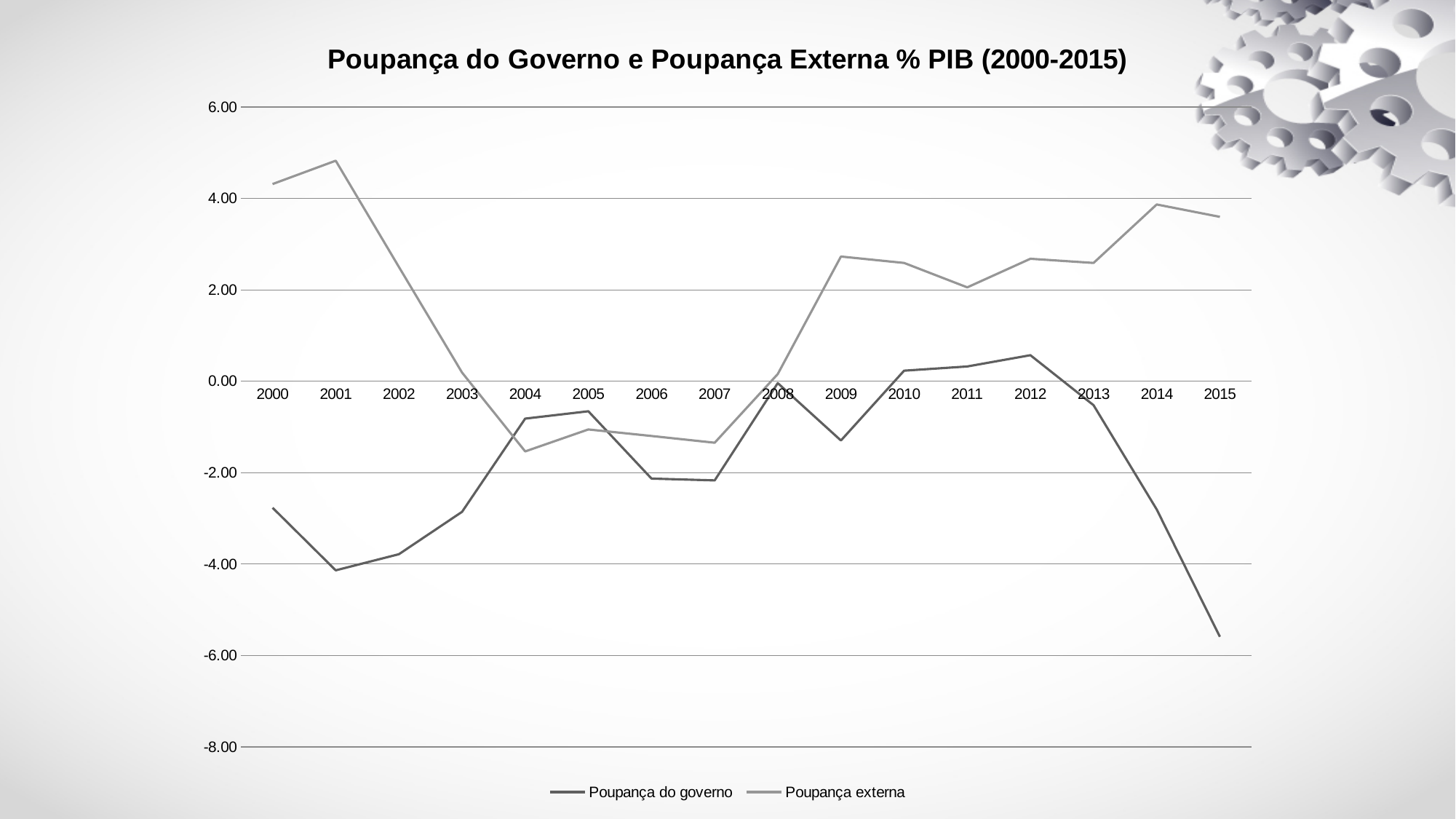
Is the value for Poupança externa in 2001 greater or less than 4.00? greater In which year is Poupança externa at its highest? 2001 Does Poupança do governo rise or fall from 2012 to 2015? fall What kind of chart is shown on the slide? line chart What is the title of the chart? Poupança do Governo e Poupança Externa % PIB (2000-2015) How many series does the legend list? 2 Is the value for Poupança externa in 2014 greater or less than 2.00? greater Is the value for Poupança do governo in 2015 greater or less than -4.00? less Which series has the higher value in 2012, Poupança do governo or Poupança externa? Poupança externa In which year is Poupança do governo at its lowest? 2015 Which series has the higher value in 2004, Poupança do governo or Poupança externa? Poupança do governo How many years are plotted along the x axis? 16